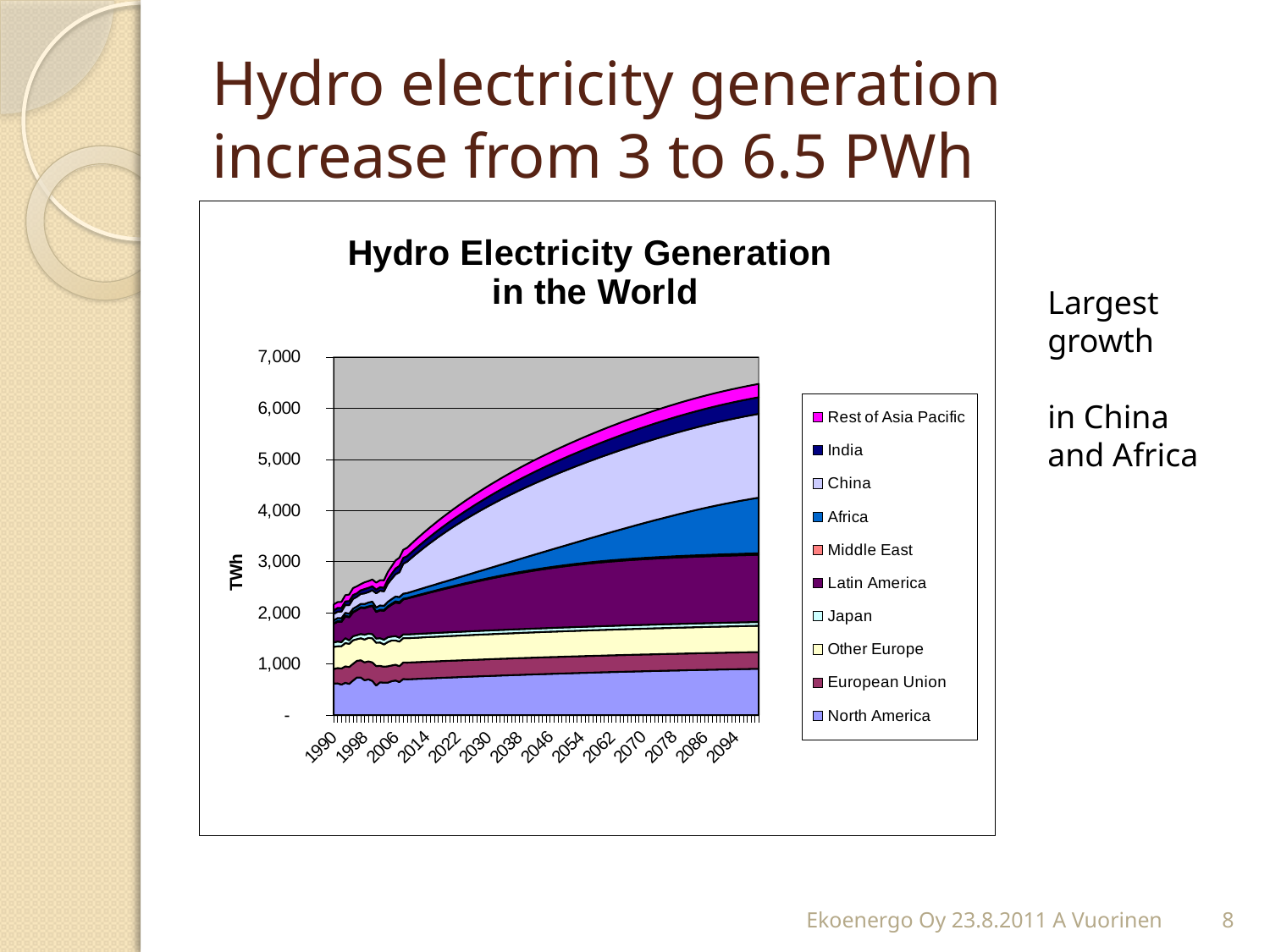
What is the title of the chart? Hydro Electricity Generation in the World Is the total hydro electricity generation in 2094 greater or less than 7,000 TWh? less Which series is larger in 2094, China or Japan? China What is the highest value shown on the y-axis of the chart? 7,000 Is the total hydro electricity generation in 1990 greater or less than 3,000 TWh? less How many series does the chart legend list? 10 Does total hydro electricity generation rise or fall from 1990 to 2094 in the chart? Rises What unit is shown on the y-axis label of the chart? TWh What kind of chart is shown on the slide? Stacked area chart Is the total hydro electricity generation in 2094 greater or less than 6,000 TWh? greater Which series is larger in 2094, Latin America or Middle East? Latin America How many year labels are shown on the x-axis of the chart? 14